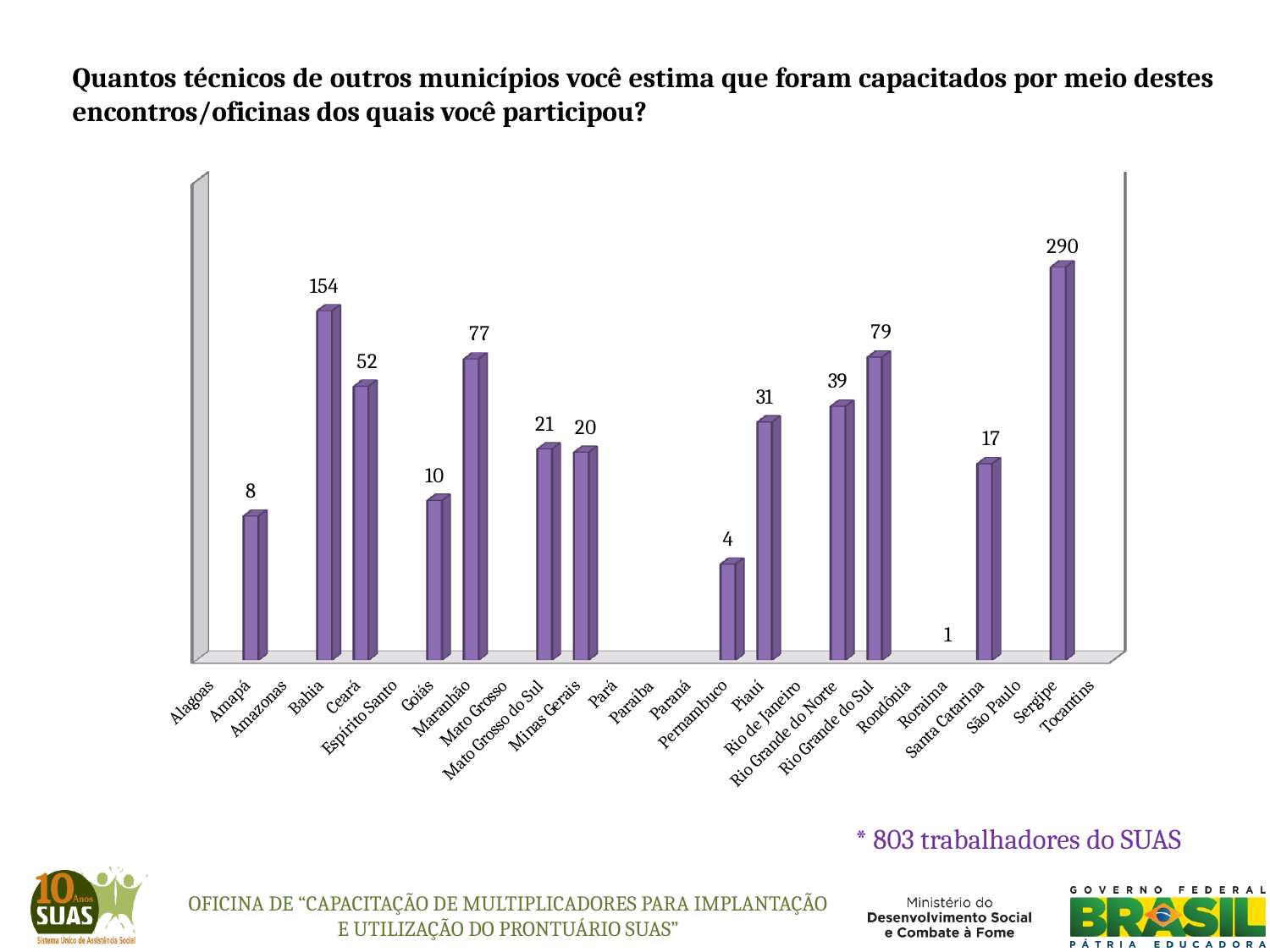
Which state has the highest value? Sergipe Which is larger, the value for Maranhão or the value for Rio Grande do Sul? Rio Grande do Sul Which state with a labelled value has the lowest value? Roraima What kind of chart is shown on the slide? Bar chart What is the difference between the values for Sergipe and Bahia? 136 What value is shown for Pernambuco? 4 What value is shown for Sergipe? 290 What value is shown for Rio Grande do Sul? 79 What value is shown for Bahia? 154 How many states are listed on the x axis? 25 What value is shown for Santa Catarina? 17 What is the difference between the values for Bahia and Ceará? 102